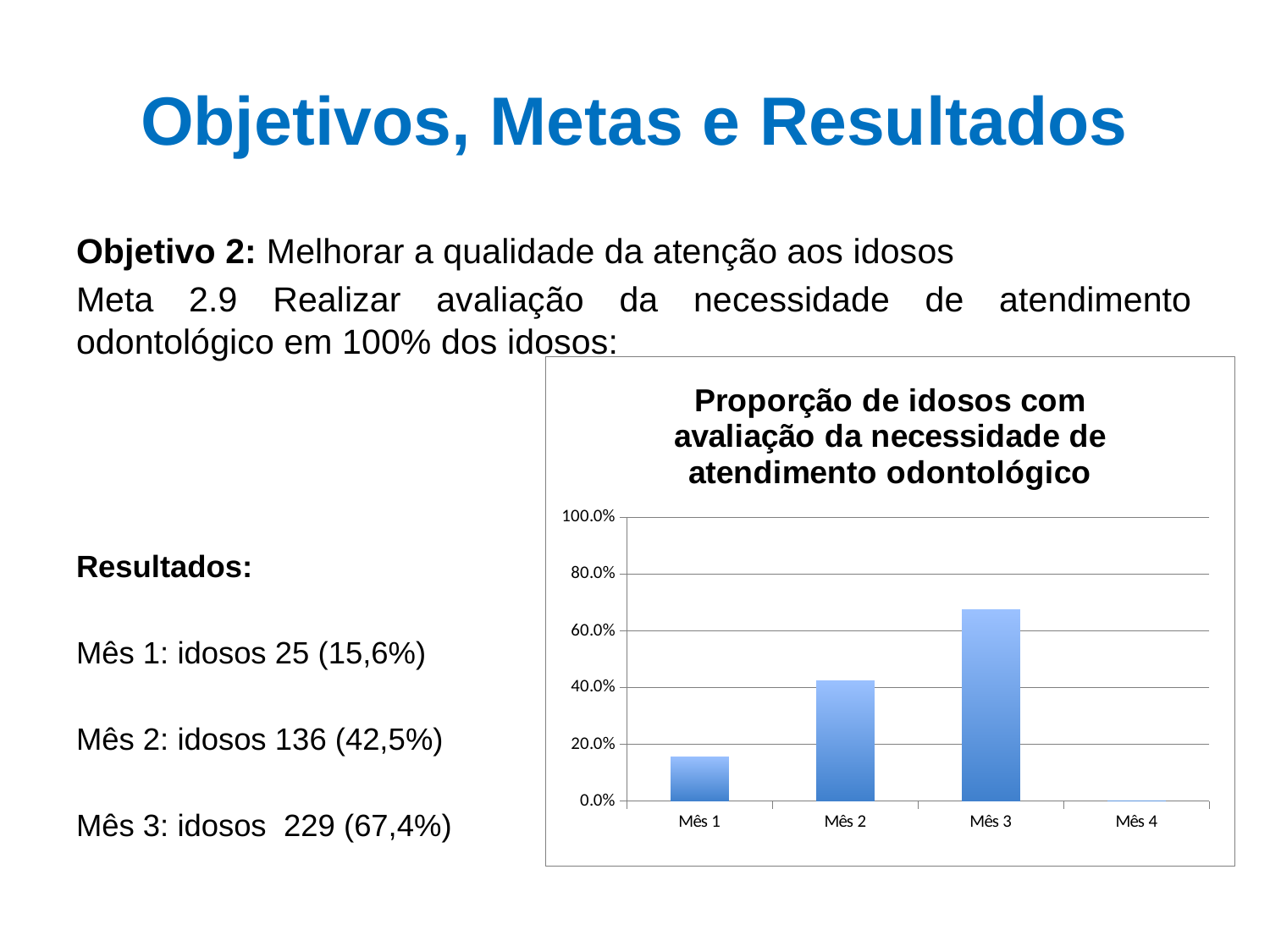
Is the value for Mês 2 greater or less than 40.0%? greater What is the title of the chart? Proporção de idosos com avaliação da necessidade de atendimento odontológico Do the values rise or fall from Mês 1 to Mês 3? rise Is the value for Mês 3 greater or less than 80.0%? less Which is larger, the value for Mês 2 or the value for Mês 1? Mês 2 According to the slide, what proportion of idosos had the dental evaluation in Mês 3? 67,4% Which month has the tallest bar in the chart? Mês 3 What kind of chart is shown on the slide? bar chart Is the value for Mês 3 greater or less than 60.0%? greater How many categories are shown on the x axis of the chart? 4 According to the slide, what proportion of idosos had the dental evaluation in Mês 2? 42,5%